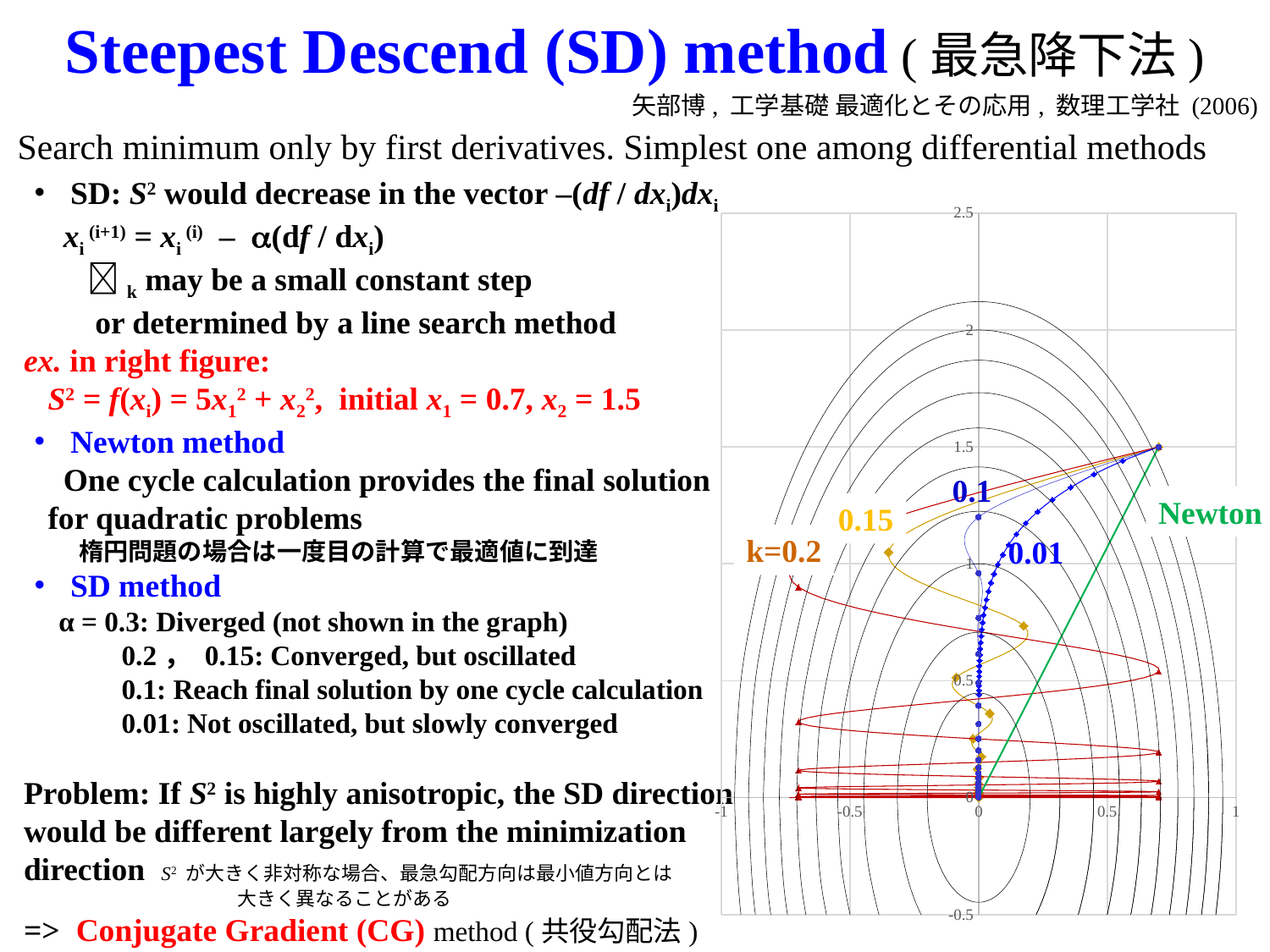
Which labeled path reaches the minimum in a single straight line? Newton How many labeled paths (step sizes plus Newton) are drawn on the chart? 5 What colour is the path labeled 0.01 in the chart? blue What is the lowest tick value shown on the horizontal axis of the chart? -1 Is the horizontal coordinate of the starting point of the paths greater or less than 0.5? greater Which labeled step size produces the widest horizontal oscillations in the chart? k=0.2 What colour is the Newton path in the chart? green What is the highest tick value shown on the vertical axis of the chart? 2.5 What is the x1 value of the initial point from which all paths start in the chart? 0.7 What is the x2 value of the initial point from which all paths start in the chart? 1.5 What is the lowest tick value shown on the vertical axis of the chart? -0.5 What kind of chart is shown on the right of the slide? scatter chart